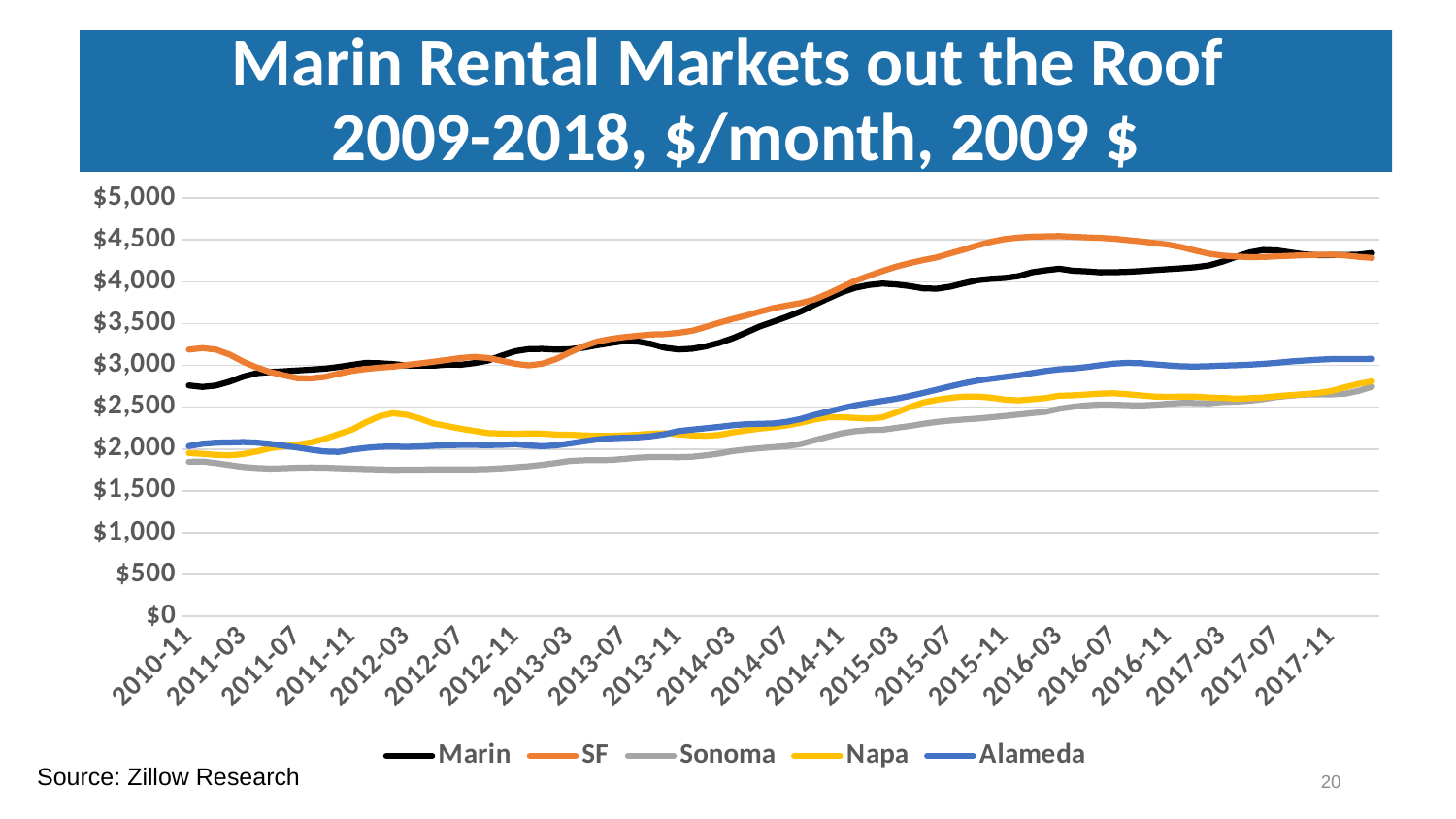
Which series has the lowest value at 2010-11? Sonoma What is the title of the chart? Marin Rental Markets out the Roof 2009-2018, $/month, 2009 $ At 2012-03, which is larger, the value for Napa or the value for Sonoma? Napa Is the value for Marin at 2017-07 greater or less than $4,000? greater Does the Marin series generally rise or fall from 2010-11 to 2017-11? rise Is the value for Marin at 2010-11 greater or less than $2,500? greater What kind of chart is shown on the slide? line chart Which series has the highest value at 2010-11? SF Is the value for Sonoma at 2017-11 greater or less than $2,500? greater How many series does the legend list? 5 Which series has the highest value at 2015-11? SF